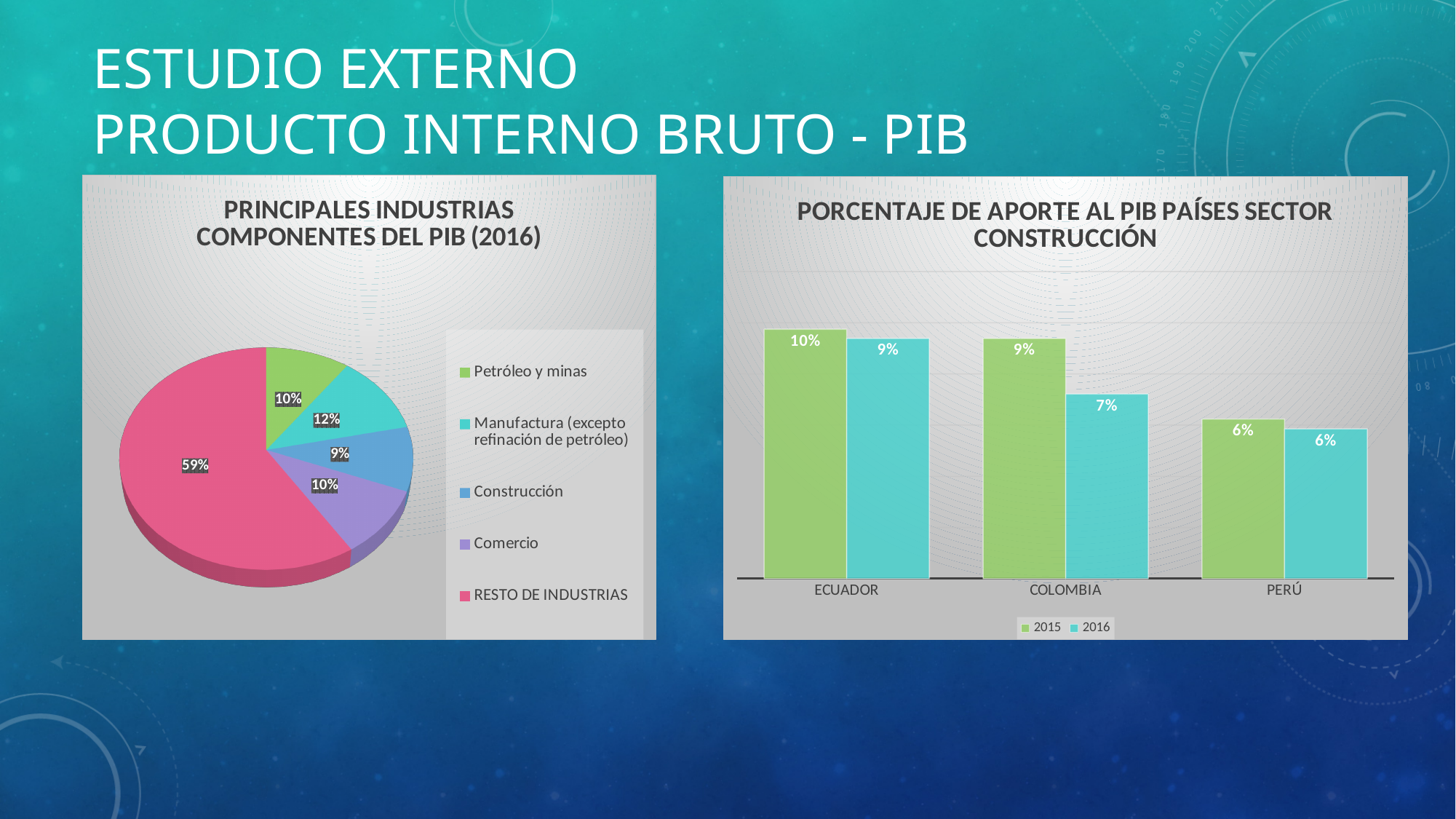
In the pie chart 'Principales industrias componentes del PIB (2016)', what share does Resto de industrias have? 59% In the bar chart 'Porcentaje de aporte al PIB países sector construcción', what is the difference between Colombia's 2015 and 2016 values? 2% In the pie chart 'Principales industrias componentes del PIB (2016)', what share does Construcción have? 9% In the pie chart 'Principales industrias componentes del PIB (2016)', what share does Manufactura (excepto refinación de petróleo) have? 12% What kind of chart is the chart on the left of the slide? Pie chart What kind of chart is the chart on the right of the slide? Bar chart In the bar chart 'Porcentaje de aporte al PIB países sector construcción', what is the value for Colombia in 2016? 7% In the bar chart 'Porcentaje de aporte al PIB países sector construcción', what is the value for Ecuador in 2015? 10% In the bar chart 'Porcentaje de aporte al PIB países sector construcción', which country has the lowest value in 2016? Perú In the bar chart 'Porcentaje de aporte al PIB países sector construcción', how many series does the legend list? 2 In the pie chart 'Principales industrias componentes del PIB (2016)', which category has the smallest slice? Construcción In the pie chart 'Principales industrias componentes del PIB (2016)', how many slices are there? 5